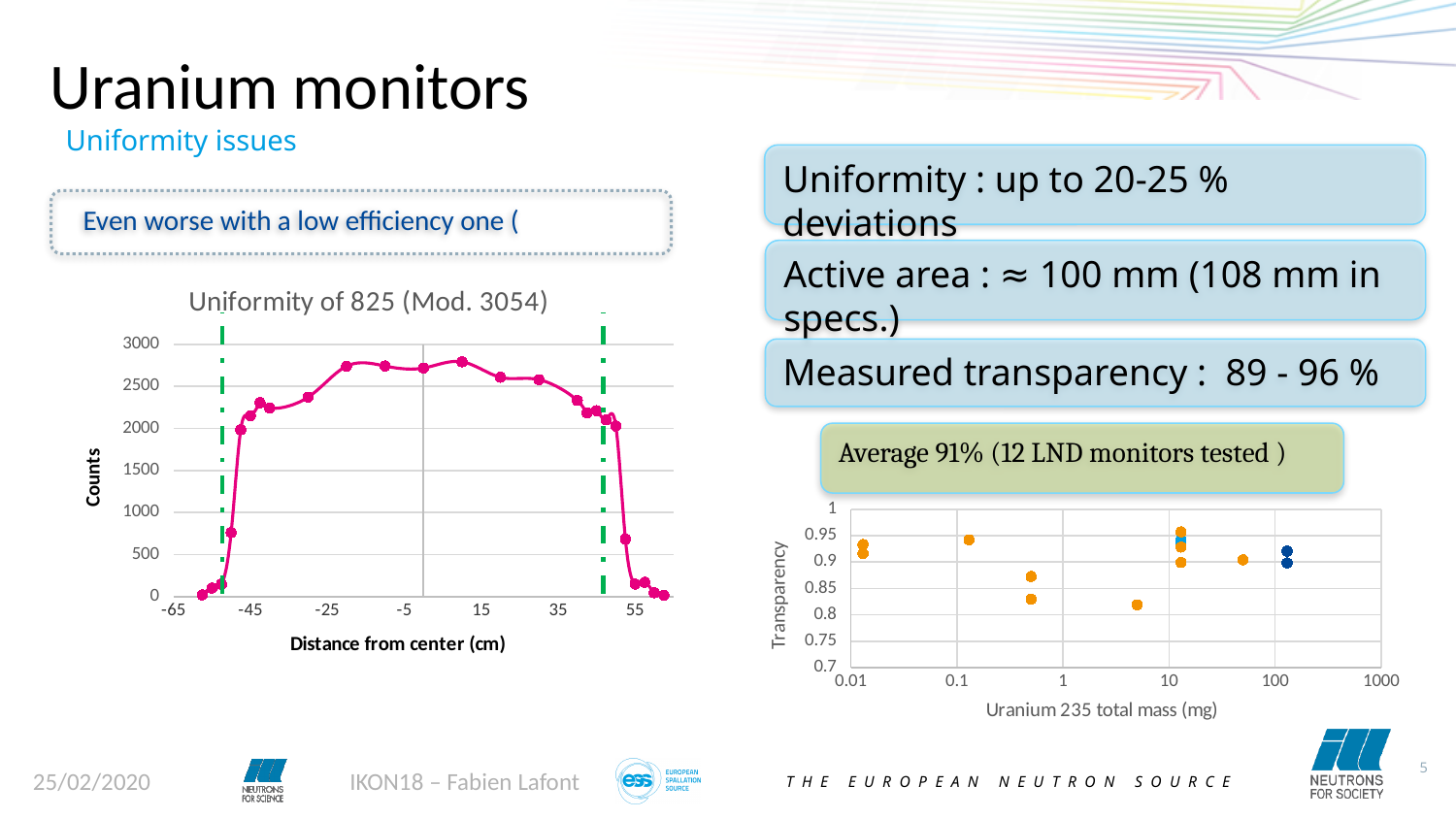
In the scatter chart on the lower right of the slide, what is the label of the x axis? Uranium 235 total mass (mg) What is the title of the chart on the left of the slide? Uniformity of 825 (Mod. 3054) In the chart titled 'Uniformity of 825 (Mod. 3054)', do the counts rise or fall as the distance from center goes from -50 cm to -30 cm? rise In the chart titled 'Uniformity of 825 (Mod. 3054)', do the counts rise or fall as the distance from center goes from 35 cm to 55 cm? fall In the scatter chart on the lower right of the slide, is the transparency of the point at about 5 mg of Uranium 235 greater or less than 0.85? less What kind of chart is the one on the lower right of the slide, plotting Transparency against Uranium 235 total mass? scatter chart In the chart titled 'Uniformity of 825 (Mod. 3054)', what is the label of the y axis? Counts In the chart titled 'Uniformity of 825 (Mod. 3054)', is the count at a distance of -45 cm from center greater or less than 2000? greater In the chart titled 'Uniformity of 825 (Mod. 3054)', is the count at a distance of 60 cm from center greater or less than 500? less